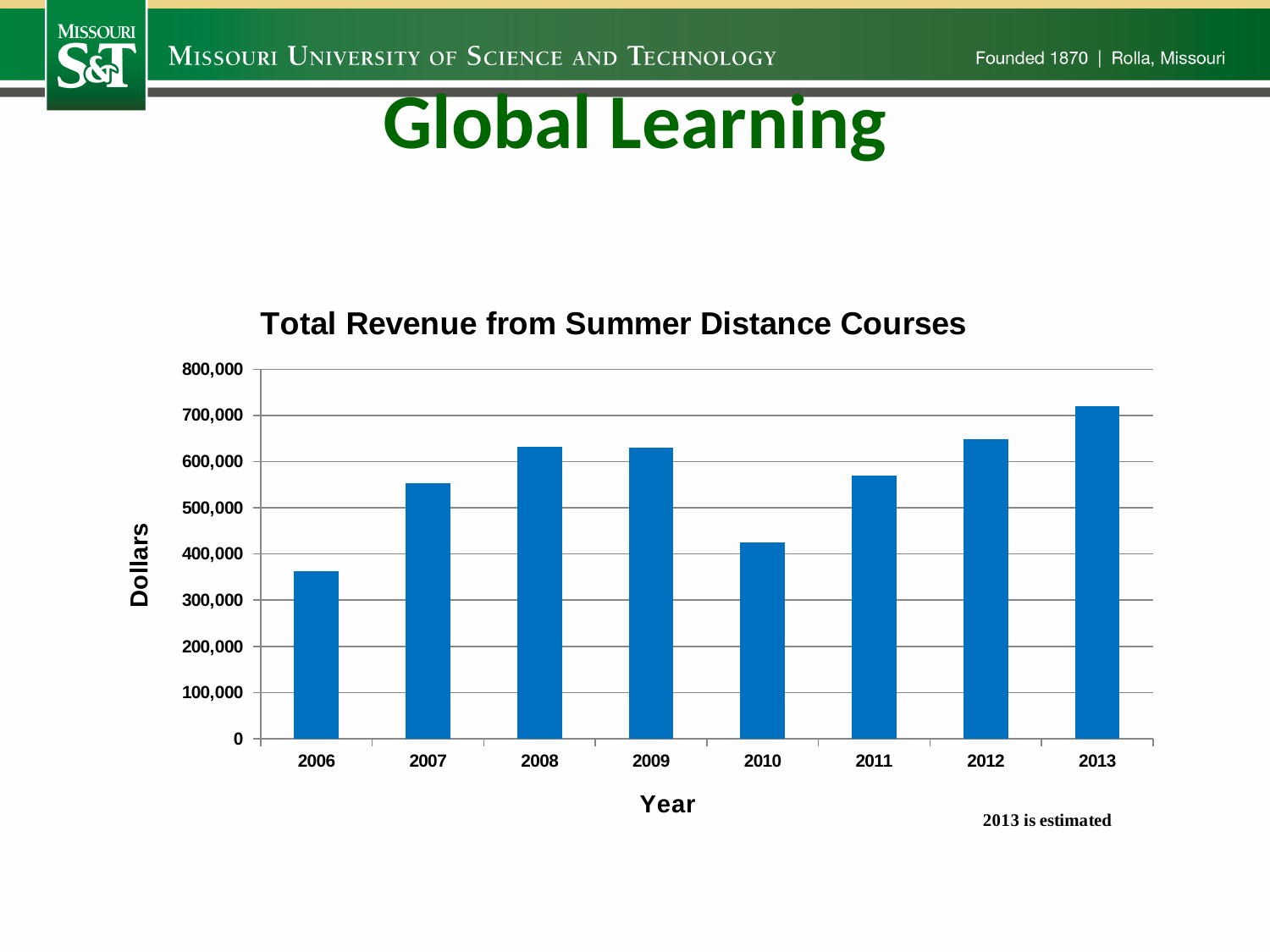
Is the value for 2012 greater or less than 600,000? greater Is the value for 2010 greater or less than 500,000? less Which year has the lowest total revenue from summer distance courses? 2006 What is the label of the y axis of the chart? Dollars Is the value for 2006 greater or less than 400,000? less What type of chart is shown on the slide? bar chart What is the title of the chart? Total Revenue from Summer Distance Courses Which year has the larger revenue, 2007 or 2008? 2008 Which year has the highest total revenue from summer distance courses? 2013 Which year has the larger revenue, 2010 or 2011? 2011 How many years are shown on the x axis of the chart? 8